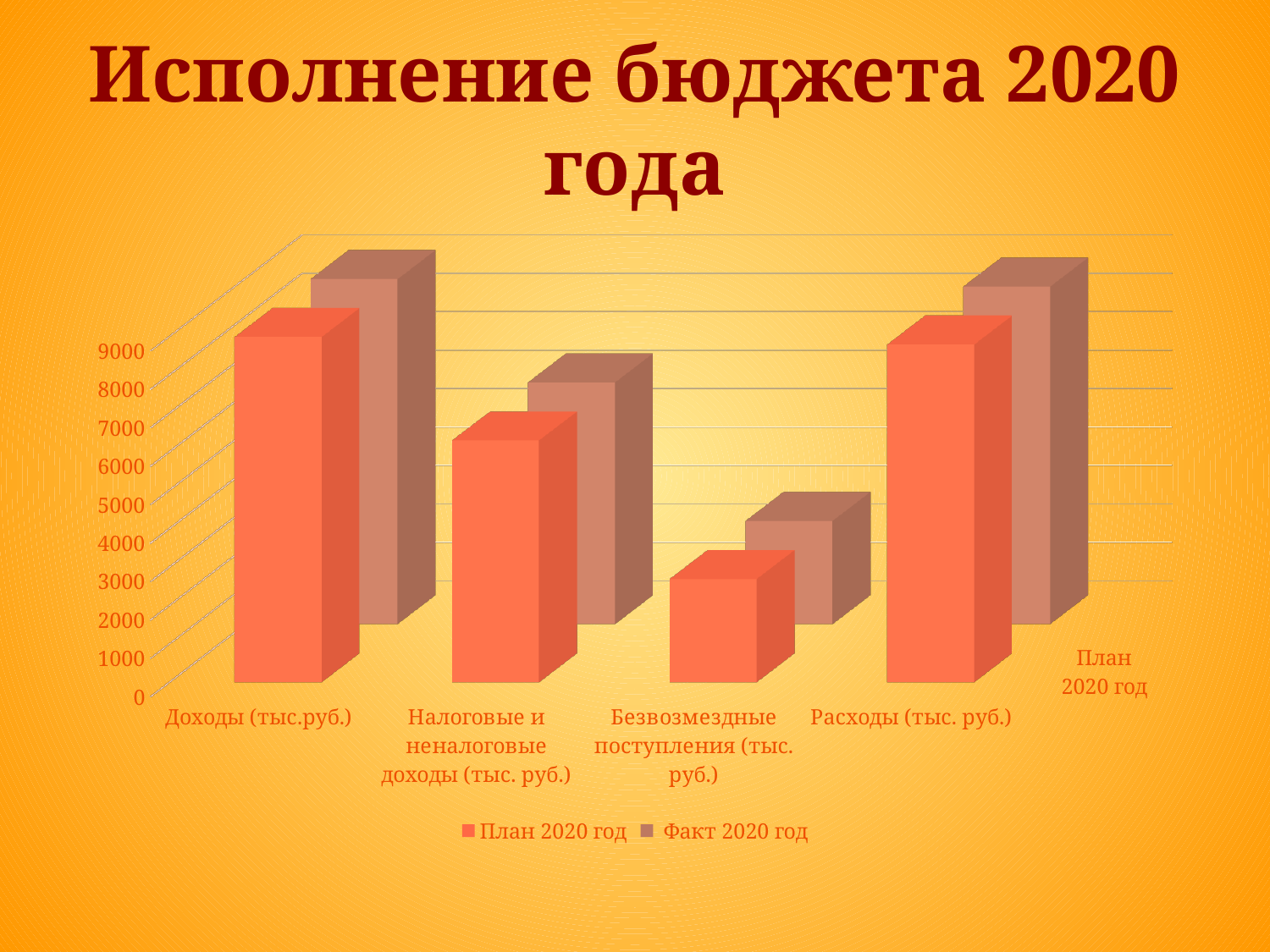
Which category has the lowest value for the series Факт 2020 год? Безвозмездные поступления (тыс. руб.) Is the value for Налоговые и неналоговые доходы (тыс. руб.) in the series План 2020 год greater or less than 5000? greater How many series does the chart legend list? 2 Which category has the lowest value for the series План 2020 год? Безвозмездные поступления (тыс. руб.) Is the value for Доходы (тыс.руб.) in the series План 2020 год greater or less than 7000? greater Within the series План 2020 год, which is larger: Налоговые и неналоговые доходы (тыс. руб.) or Безвозмездные поступления (тыс. руб.)? Налоговые и неналоговые доходы (тыс. руб.) What kind of chart is shown on the slide? bar chart How many categories are shown on the x axis of the chart? 4 What is the title of the slide containing the chart? Исполнение бюджета 2020 года Is the value for Безвозмездные поступления (тыс. руб.) in the series План 2020 год greater or less than 5000? less